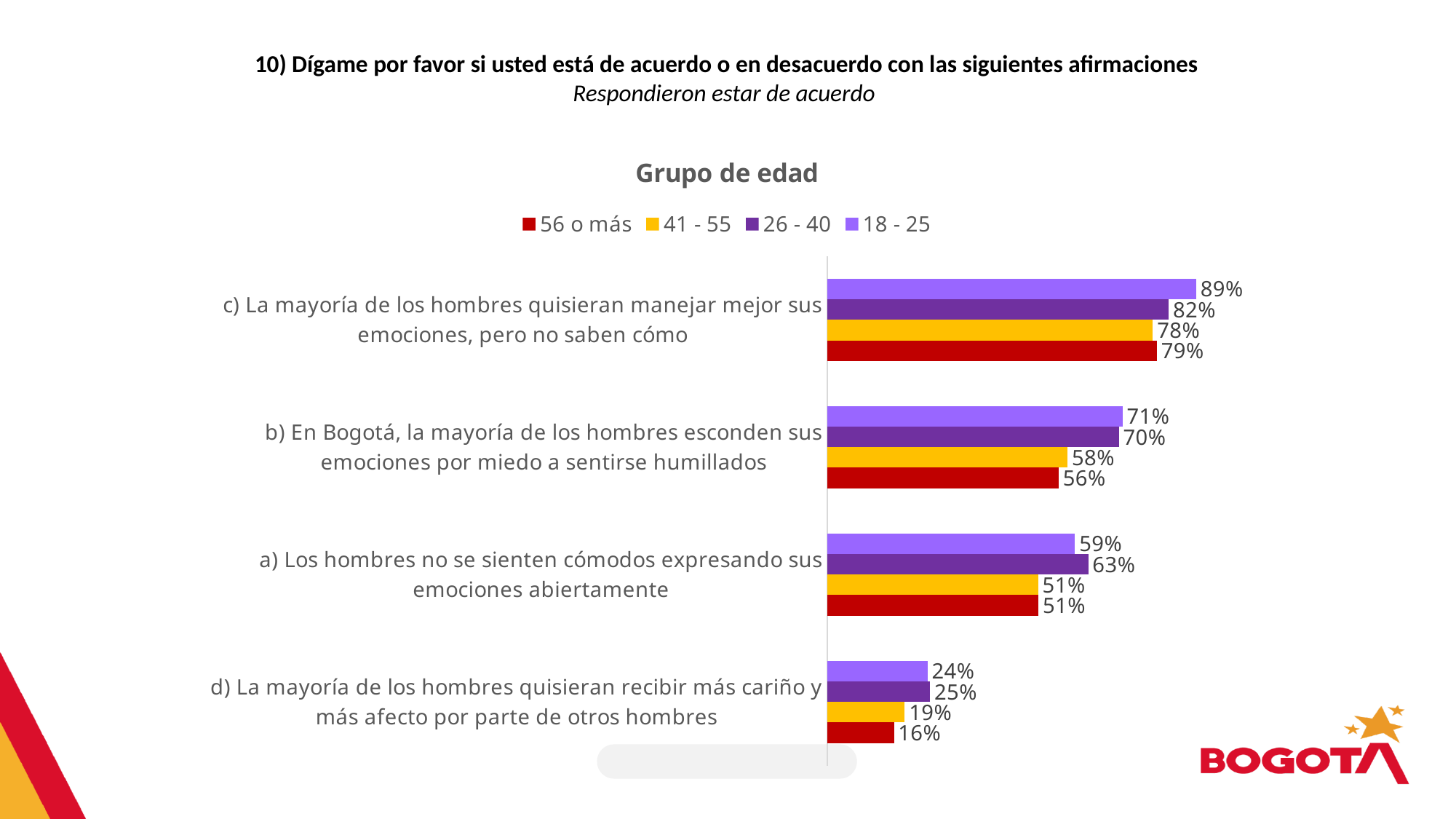
What type of chart is shown on the slide? Bar chart How many statements (categories) are shown in the chart? 4 For statement a) 'Los hombres no se sienten cómodos expresando sus emociones abiertamente', which is larger: the 26 - 40 value or the 18 - 25 value? 26 - 40 How many age groups does the legend list? 4 What percentage of the 41 - 55 age group agreed with statement b) 'En Bogotá, la mayoría de los hombres esconden sus emociones por miedo a sentirse humillados'? 58% What is the title of the chart? Grupo de edad What percentage of the 18 - 25 age group agreed with statement c) 'La mayoría de los hombres quisieran manejar mejor sus emociones, pero no saben cómo'? 89% Which age group has the highest agreement with statement c) 'La mayoría de los hombres quisieran manejar mejor sus emociones, pero no saben cómo'? 18 - 25 What is the difference between the 18 - 25 and 56 o más values for statement b) 'En Bogotá, la mayoría de los hombres esconden sus emociones por miedo a sentirse humillados'? 15% Which age group has the lowest agreement with statement d) 'La mayoría de los hombres quisieran recibir más cariño y más afecto por parte de otros hombres'? 56 o más What percentage of the 26 - 40 age group agreed with statement a) 'Los hombres no se sienten cómodos expresando sus emociones abiertamente'? 63% What percentage of the 56 o más age group agreed with statement d) 'La mayoría de los hombres quisieran recibir más cariño y más afecto por parte de otros hombres'? 16%